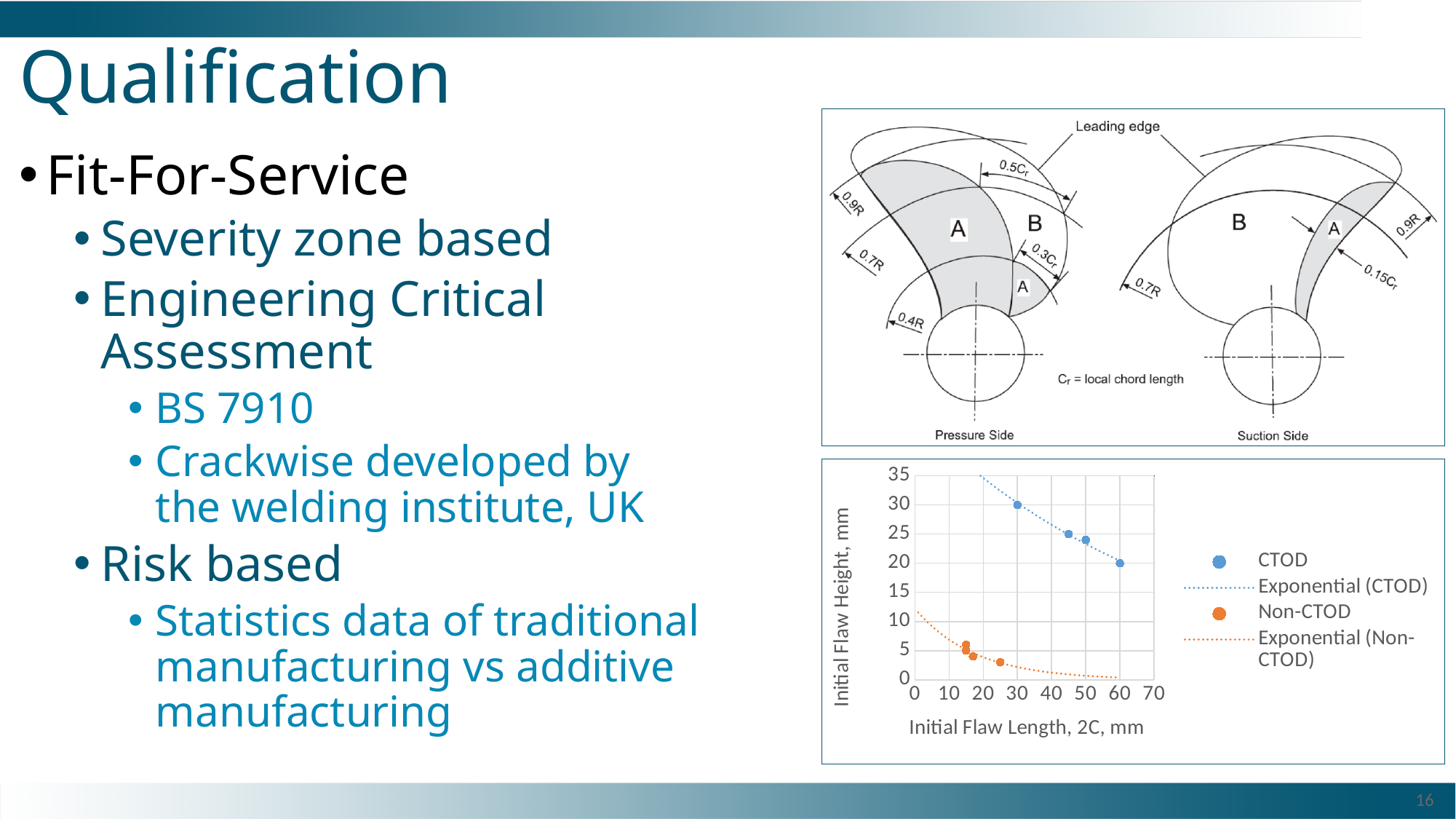
Which series has the higher initial flaw heights, CTOD or Non-CTOD? CTOD What is the title of the x axis of the chart? Initial Flaw Length, 2C, mm Is the initial flaw height of the CTOD point at a flaw length of 60 mm greater or less than 25? less What is the title of the y axis of the chart? Initial Flaw Height, mm How many entries does the chart legend list? 4 Is the highest Non-CTOD initial flaw height greater or less than 10? less How many CTOD data points are plotted on the chart? 4 Is the initial flaw height of the Non-CTOD point at a flaw length of about 25 mm greater or less than 5? less What kind of chart is shown on the slide? scatter chart Which series contains the point with the highest initial flaw height? CTOD Do the CTOD points rise or fall as the initial flaw length increases? fall